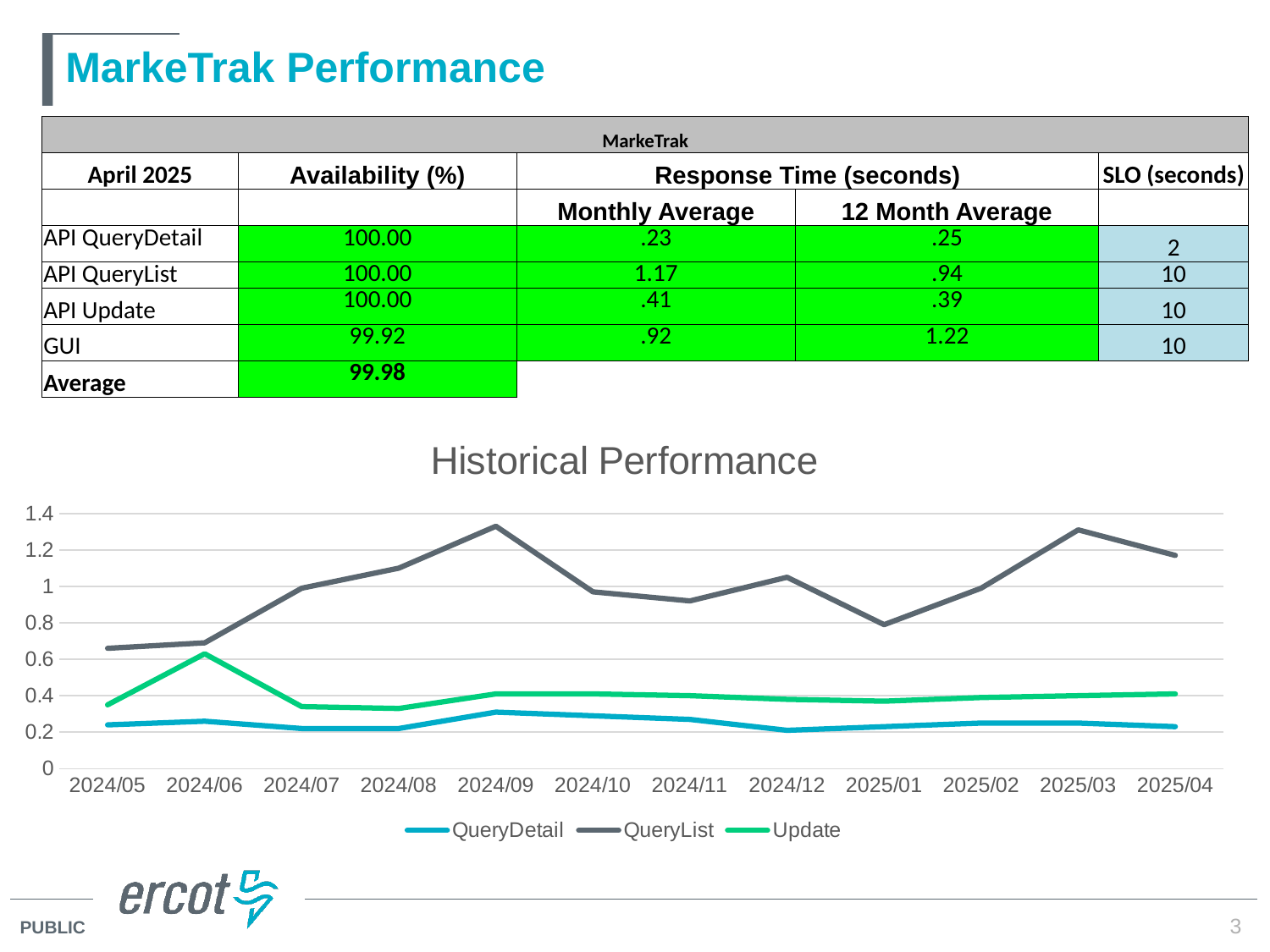
What is the title of the chart on the slide? Historical Performance In the Historical Performance chart, is the QueryList value for 2025/03 greater or less than 1.2? greater How many series does the legend of the Historical Performance chart list? 3 How many months are plotted along the x axis of the Historical Performance chart? 12 In the Historical Performance chart, does the QueryList series rise or fall from 2024/05 to 2024/09? rise In the Historical Performance chart, is the Update value for 2024/07 greater or less than 0.4? less In the Historical Performance chart, is the QueryDetail value for 2024/12 greater or less than 0.4? less Which series in the Historical Performance chart is drawn in green? Update What kind of chart is the Historical Performance chart? line chart Which series reaches the highest value in the Historical Performance chart? QueryList In which month does the Update series reach its highest value in the Historical Performance chart? 2024/06